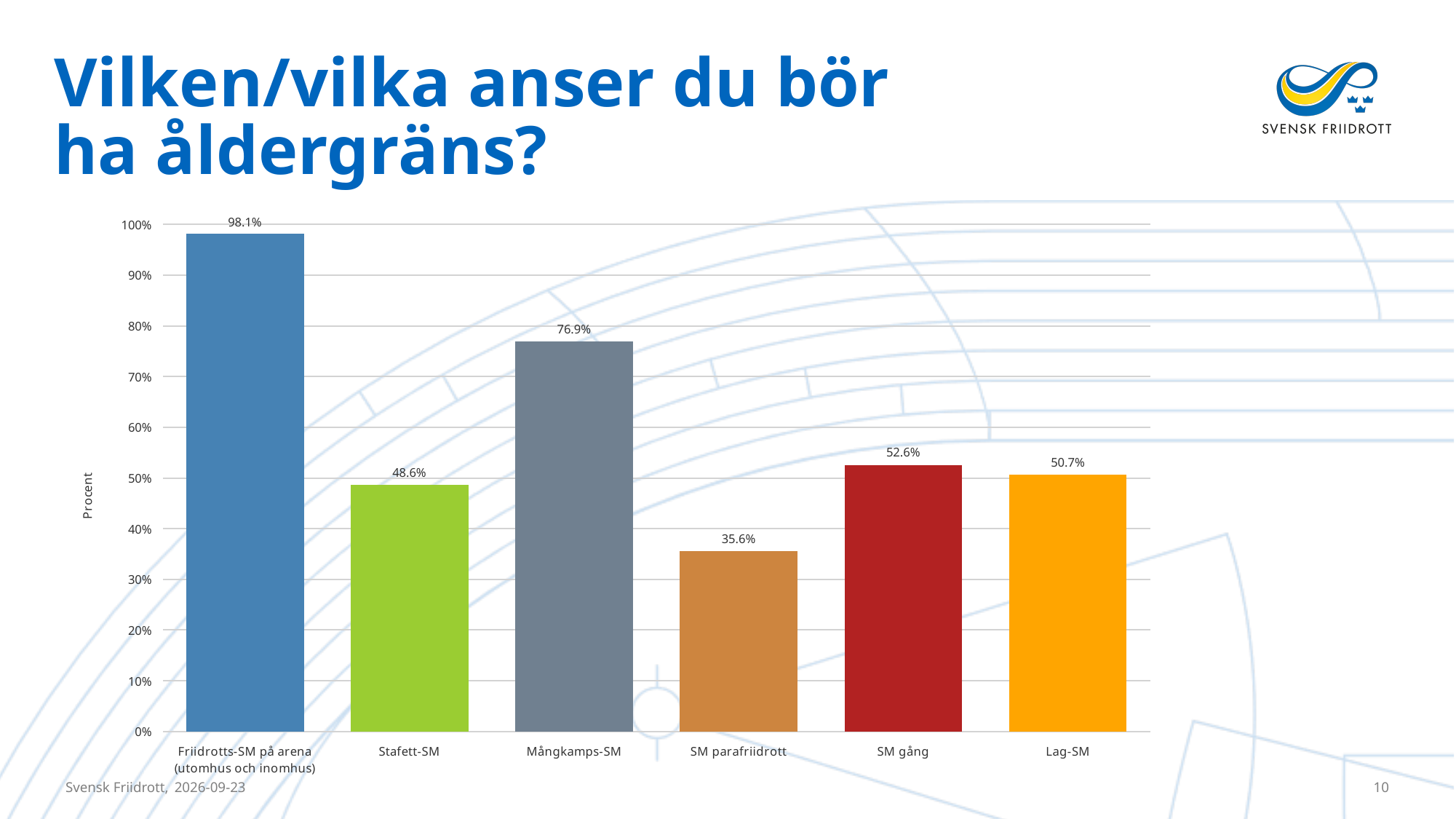
Which category has the highest value? Friidrotts-SM på arena (utomhus och inomhus) What is the difference between the values for Friidrotts-SM på arena (utomhus och inomhus) and Mångkamps-SM? 21.2% Which is larger, the value for SM gång or the value for Stafett-SM? SM gång What is the value for Mångkamps-SM? 76.9% What is the value for Stafett-SM? 48.6% Is the value for Mångkamps-SM greater or less than 70%? greater What is the value for SM parafriidrott? 35.6% How many categories are shown on the x axis? 6 What kind of chart is shown on the slide? Bar chart What is the label of the vertical axis? Procent What is the value for Lag-SM? 50.7% Which category has the lowest value? SM parafriidrott